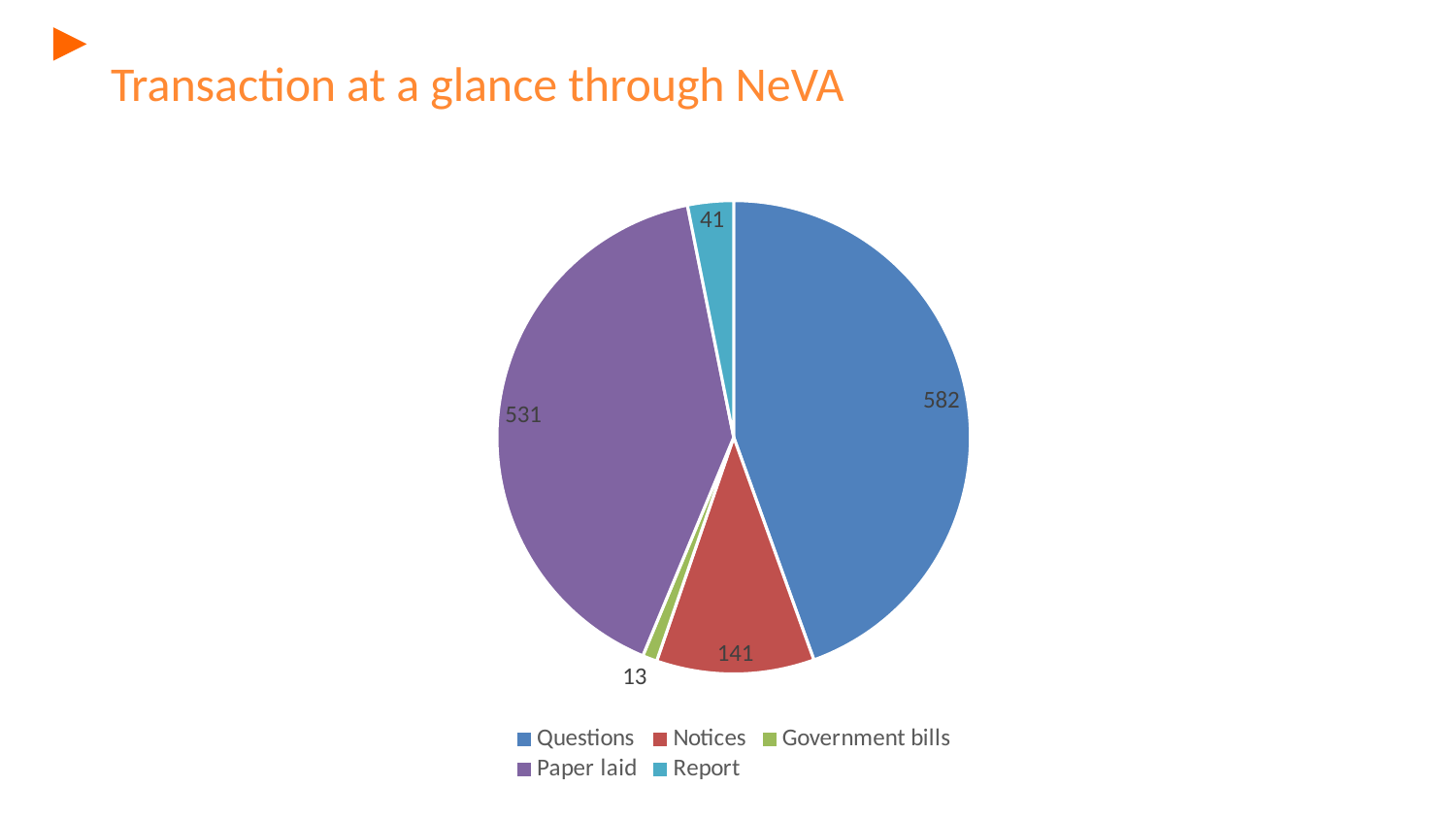
What is the value for Paper laid? 531 What is the value for Questions? 582 What is the difference between the values for Questions and Paper laid? 51 What is the title of the slide containing the chart? Transaction at a glance through NeVA What type of chart is shown on the slide? Pie chart Which category has the largest slice? Questions How many categories does the pie chart show? 5 What is the value for Government bills? 13 Which is larger, Notices or Report? Notices Which category has the smallest slice? Government bills What is the value for Notices? 141 What is the value for Report? 41